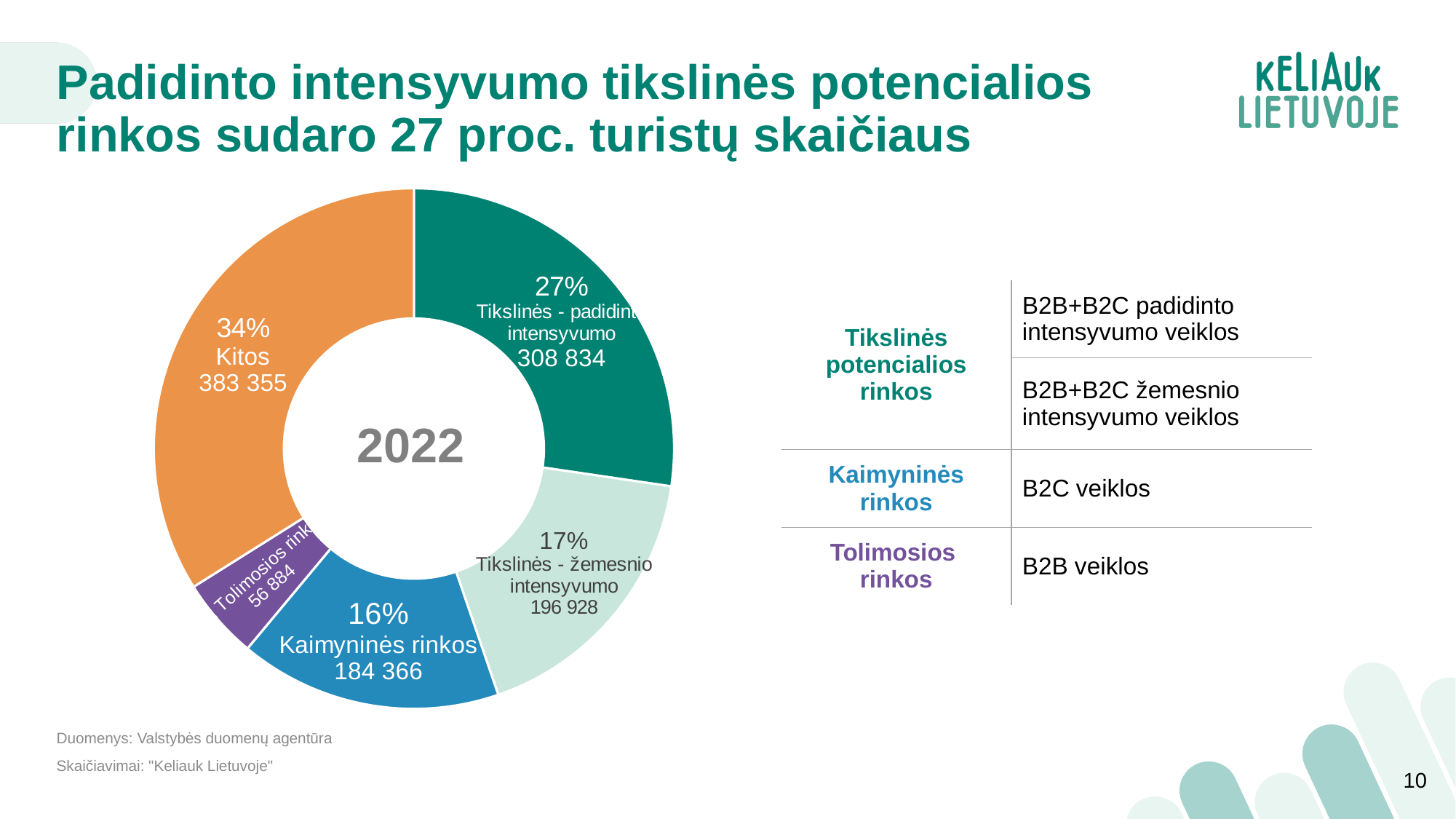
What is the difference between the Kitos value and the Tikslinės - padidinto intensyvumo value? 74 521 Which slice of the donut chart is the smallest? Tolimosios rinkos What value is shown for the Kitos slice? 383 355 How many slices does the donut chart have? 5 What share of the pie does the Tikslinės - žemesnio intensyvumo slice represent? 17% What kind of chart is shown on the slide? Pie (donut) chart What year is shown in the centre of the donut chart? 2022 What value is shown for the Tolimosios rinkos slice? 56 884 Which slice of the donut chart is the largest? Kitos Which is larger: Tikslinės - žemesnio intensyvumo or Kaimyninės rinkos? Tikslinės - žemesnio intensyvumo What value is shown for the Tikslinės - padidinto intensyvumo slice? 308 834 What value is shown for the Kaimyninės rinkos slice? 184 366